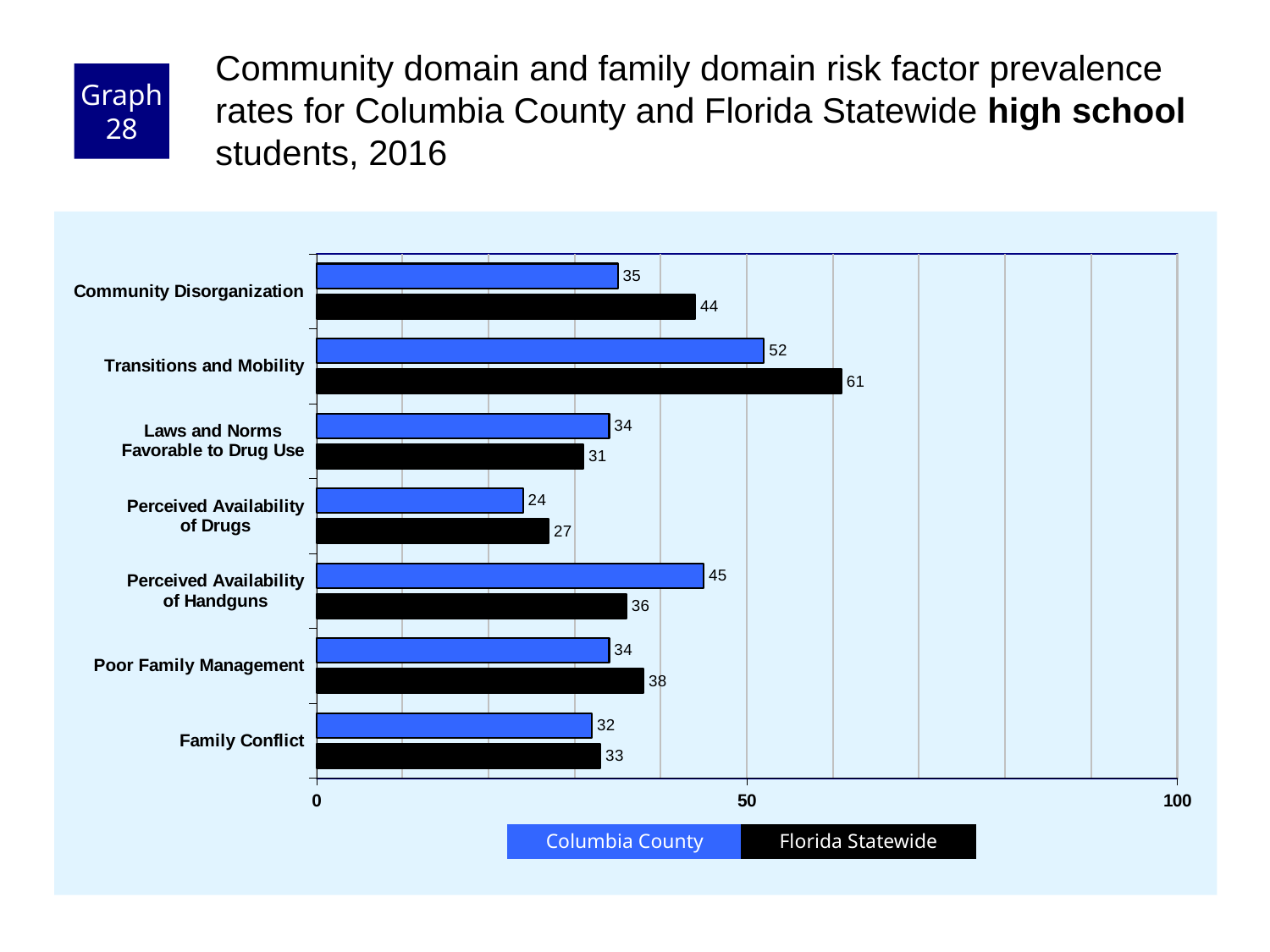
How many risk factors are shown on the chart? 7 What is the Columbia County value for Transitions and Mobility? 52 What is the difference between the Florida Statewide and Columbia County values for Community Disorganization? 9 What colour are the Florida Statewide bars? Black Is the Florida Statewide value for Transitions and Mobility greater or less than 50? greater For Perceived Availability of Handguns, which is larger: Columbia County or Florida Statewide? Columbia County How many series does the legend list? 2 What kind of chart is shown on the slide? Bar chart Which risk factor has the lowest Columbia County value? Perceived Availability of Drugs What is the Florida Statewide value for Perceived Availability of Drugs? 27 What is the Columbia County value for Perceived Availability of Handguns? 45 Which risk factor has the highest Florida Statewide value? Transitions and Mobility